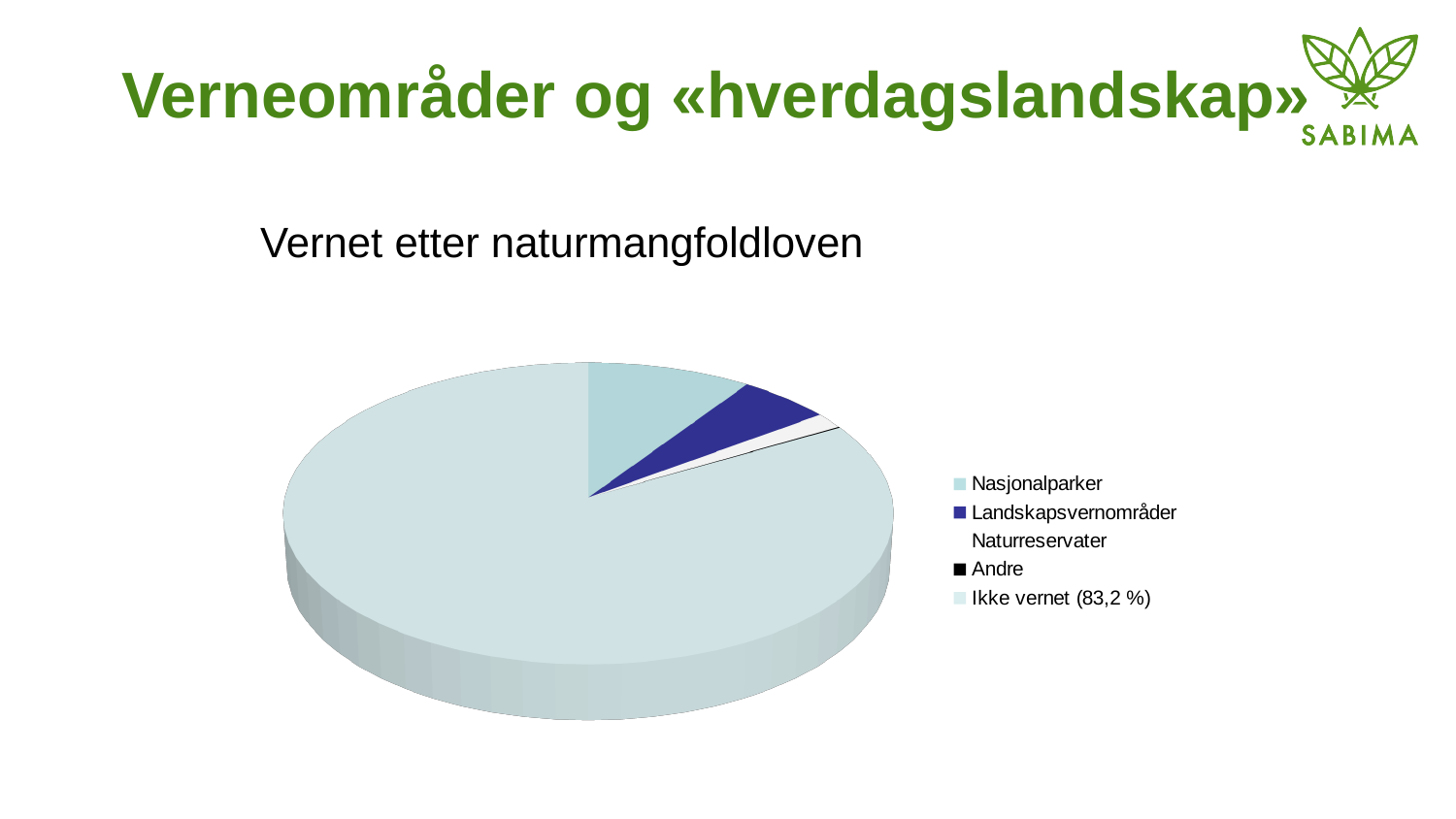
What share of the pie does the 'Ikke vernet' slice represent, as printed in the legend? 83,2 % Which legend entry is shown in dark blue? Landskapsvernområder What is the title of the pie chart? Vernet etter naturmangfoldloven Which category has the largest slice of the pie chart? Ikke vernet Which slice is larger: Nasjonalparker or Landskapsvernområder? Nasjonalparker What kind of chart is shown on the slide? pie chart How many categories does the pie chart's legend list? 5 Which slice is larger: Landskapsvernområder or Andre? Landskapsvernområder Which slice is larger: Ikke vernet or Nasjonalparker? Ikke vernet